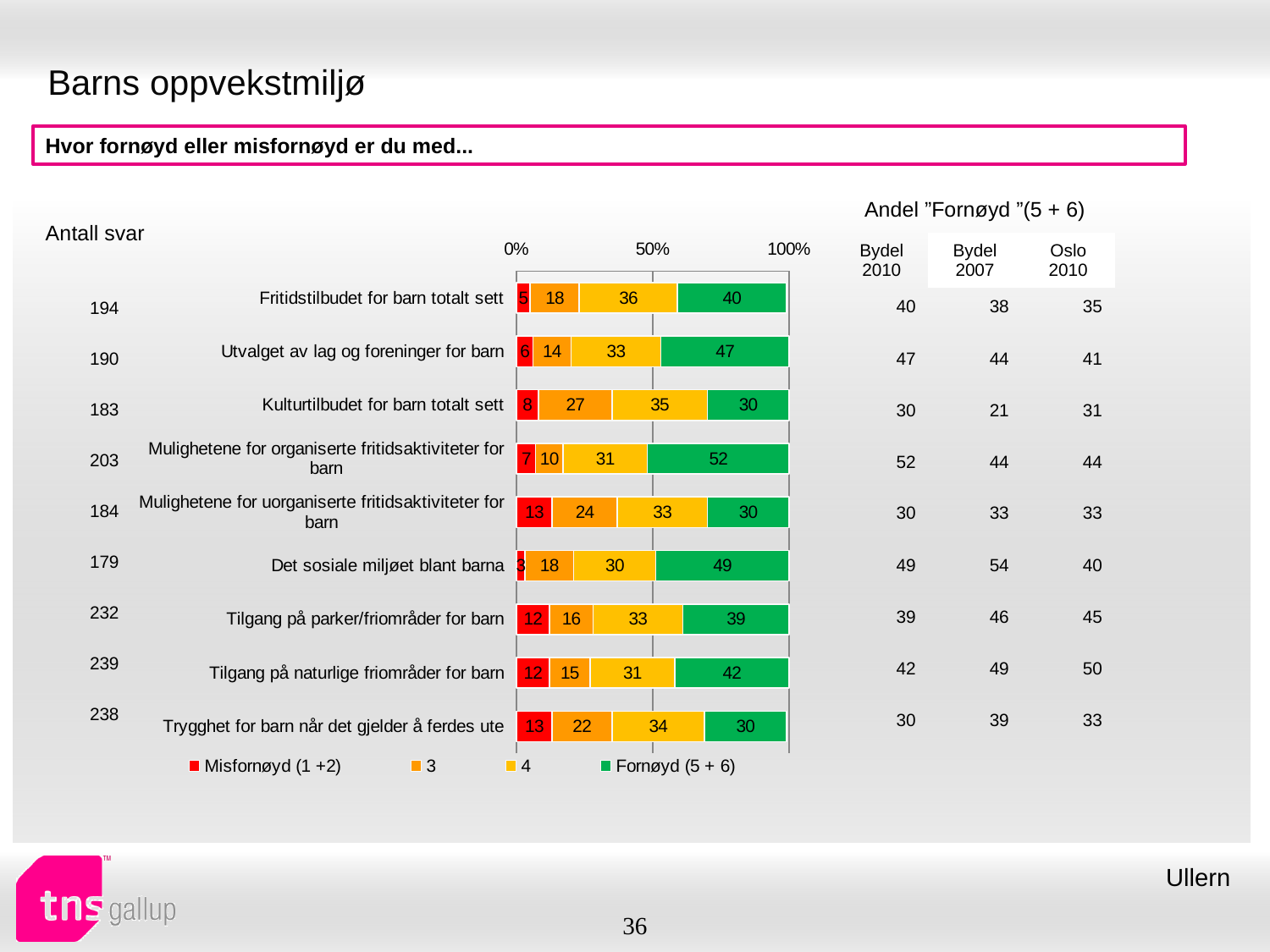
How many categories are shown in the chart? 9 Which has a larger "3" segment: "Kulturtilbudet for barn totalt sett" or "Tilgang på parker/friområder for barn"? Kulturtilbudet for barn totalt sett What type of chart is shown on the slide? Stacked bar chart What is the total of the segments in the bar for "Det sosiale miljøet blant barna"? 100 Which legend entry is shown in green? Fornøyd (5 + 6) Which category has the lowest "Misfornøyd (1 +2)" value? Det sosiale miljøet blant barna How many series does the legend list? 4 What percentage of respondents are "Fornøyd (5 + 6)" with "Mulighetene for organiserte fritidsaktiviteter for barn"? 52 What is the difference between the "Fornøyd (5 + 6)" values for "Utvalget av lag og foreninger for barn" and "Kulturtilbudet for barn totalt sett"? 17 Which category has the highest "Fornøyd (5 + 6)" value? Mulighetene for organiserte fritidsaktiviteter for barn What is the value of the "4" segment for "Fritidstilbudet for barn totalt sett"? 36 What is the "Misfornøyd (1 +2)" value for "Trygghet for barn når det gjelder å ferdes ute"? 13